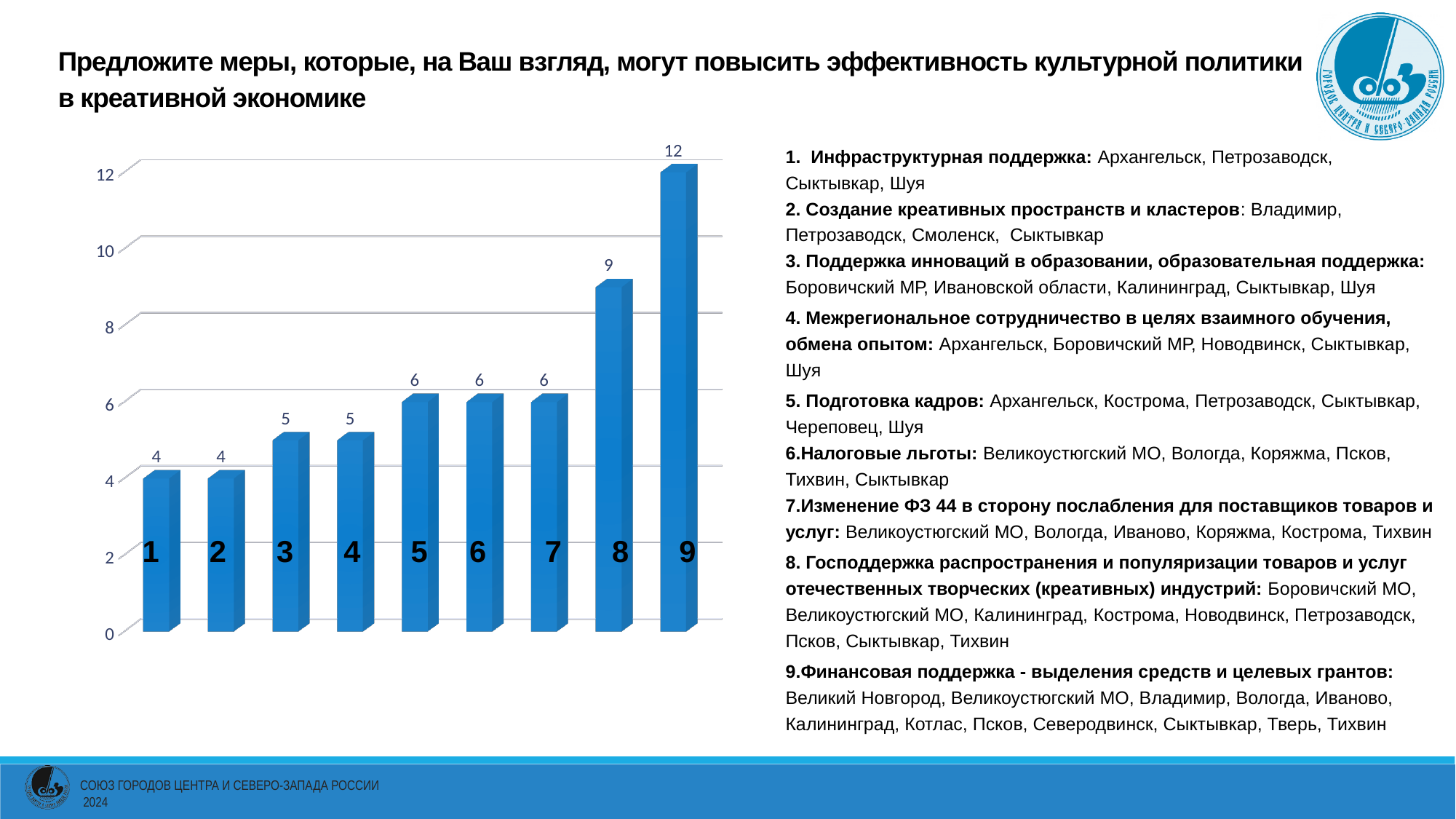
How many categories are shown in the chart? 9 Which category has the highest value? 9 What is the difference between the values for category 9 and category 8? 3 What is the value for category 9? 12 What is the value for category 3? 5 What kind of chart is shown on the slide? bar chart What is the difference between the values for category 8 and category 7? 3 Which is larger, the value for category 5 or the value for category 4? category 5 What is the value for category 8? 9 What is the value for category 1? 4 Do the values rise or fall from category 1 to category 9? rise Is the value for category 8 greater or less than 10? less